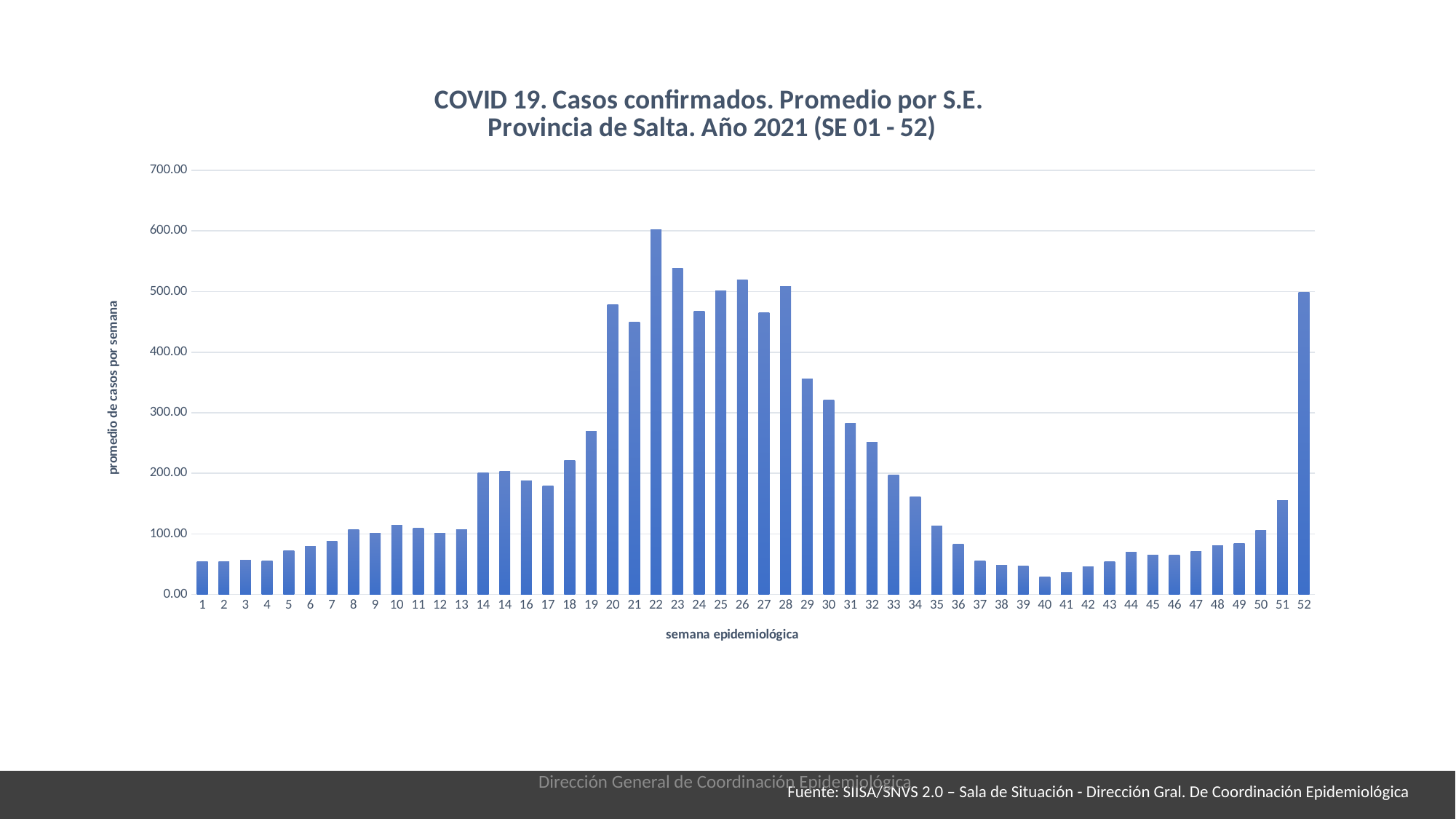
Is the value for week 40 greater or less than 100? less What is the label of the vertical axis? promedio de casos por semana How many bars are plotted in the chart? 52 Which epidemiological week has the highest average of confirmed cases? 22 Is the value for week 22 greater or less than 500? greater Is the value for week 29 greater or less than 300? greater Which epidemiological week has the lowest average of confirmed cases? 40 What kind of chart is shown on the slide? bar chart Which is larger, the value for week 1 or the value for week 14? week 14 Do the values rise or fall from week 22 to week 40? fall Which is larger, the value for week 23 or the value for week 25? week 23